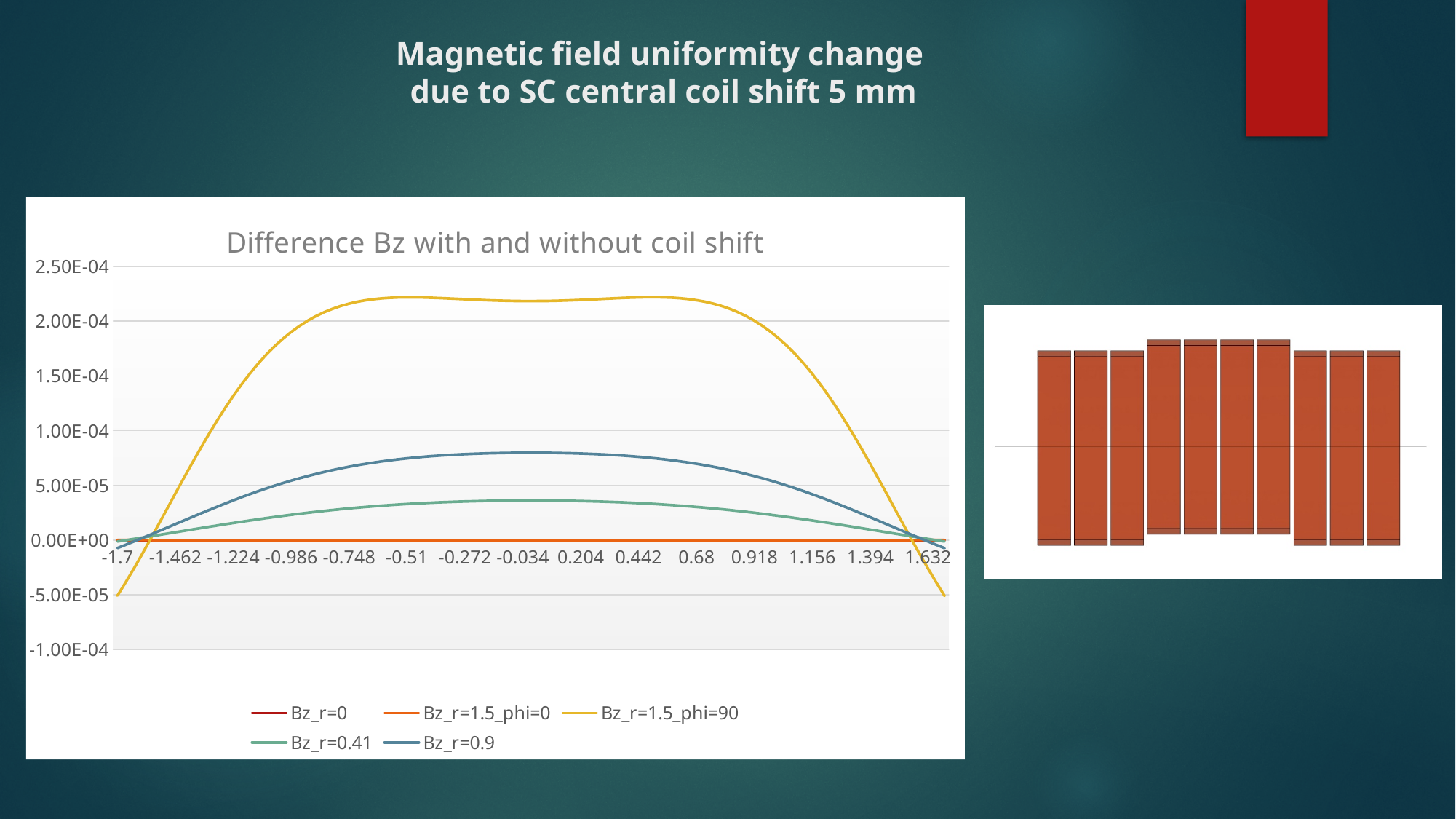
In the "Difference Bz with and without coil shift" chart, which series is higher near x = -0.034: Bz_r=0.9 or Bz_r=0.41? Bz_r=0.9 In the "Difference Bz with and without coil shift" chart, is the peak value of Bz_r=1.5_phi=90 greater or less than 2.00E-04? greater In the "Difference Bz with and without coil shift" chart, is the value of Bz_r=1.5_phi=90 at x = -1.7 greater or less than 0.00E+00? less What kind of chart is "Difference Bz with and without coil shift"? line chart How many tick labels are shown on the x axis of the "Difference Bz with and without coil shift" chart? 15 In the "Difference Bz with and without coil shift" chart, which series reaches the highest value? Bz_r=1.5_phi=90 In the "Difference Bz with and without coil shift" chart, is the peak value of Bz_r=0.9 greater or less than 5.00E-05? greater In the "Difference Bz with and without coil shift" chart, which series is higher near x = 0.204: Bz_r=1.5_phi=90 or Bz_r=0.9? Bz_r=1.5_phi=90 How many series does the legend of the "Difference Bz with and without coil shift" chart list? 5 What is the highest value shown on the y axis of the "Difference Bz with and without coil shift" chart? 2.50E-04 In the "Difference Bz with and without coil shift" chart, does the Bz_r=0.9 series rise or fall between x = -1.462 and x = -0.034? rise